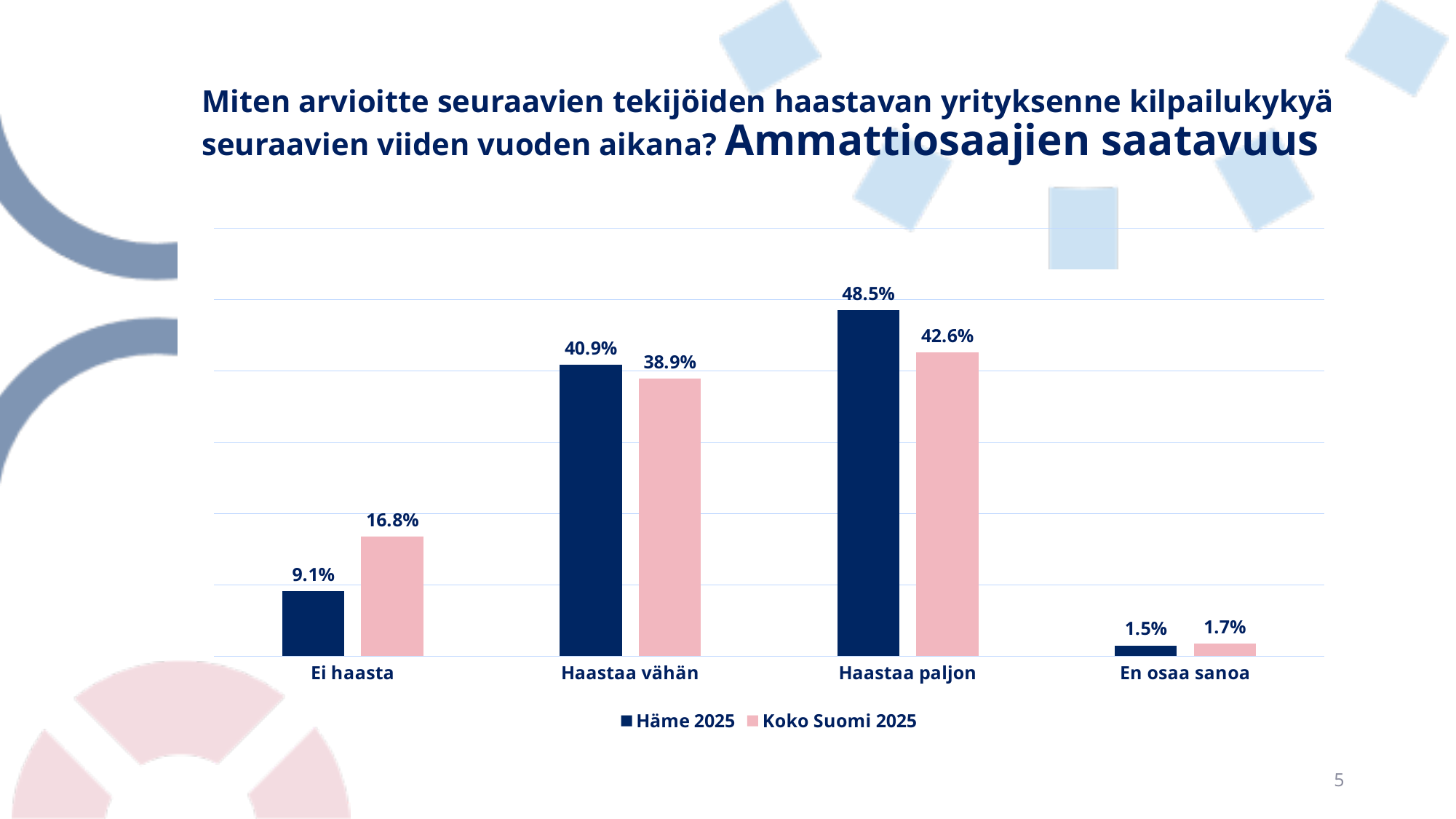
What is the value for Häme 2025 in the Haastaa paljon category? 48.5% Which is larger in the Ei haasta category, Häme 2025 or Koko Suomi 2025? Koko Suomi 2025 How many series does the legend list? 2 What is the value for Koko Suomi 2025 in the Ei haasta category? 16.8% What is the difference between Häme 2025 and Koko Suomi 2025 in the Haastaa paljon category? 5.9% What is the value for Koko Suomi 2025 in the Haastaa vähän category? 38.9% How many categories are shown on the x axis? 4 What is the value for Häme 2025 in the En osaa sanoa category? 1.5% Which category has the highest value for Häme 2025? Haastaa paljon What kind of chart is shown on the slide? Bar chart Which series is shown in pink in the legend? Koko Suomi 2025 Which category has the lowest value for Koko Suomi 2025? En osaa sanoa